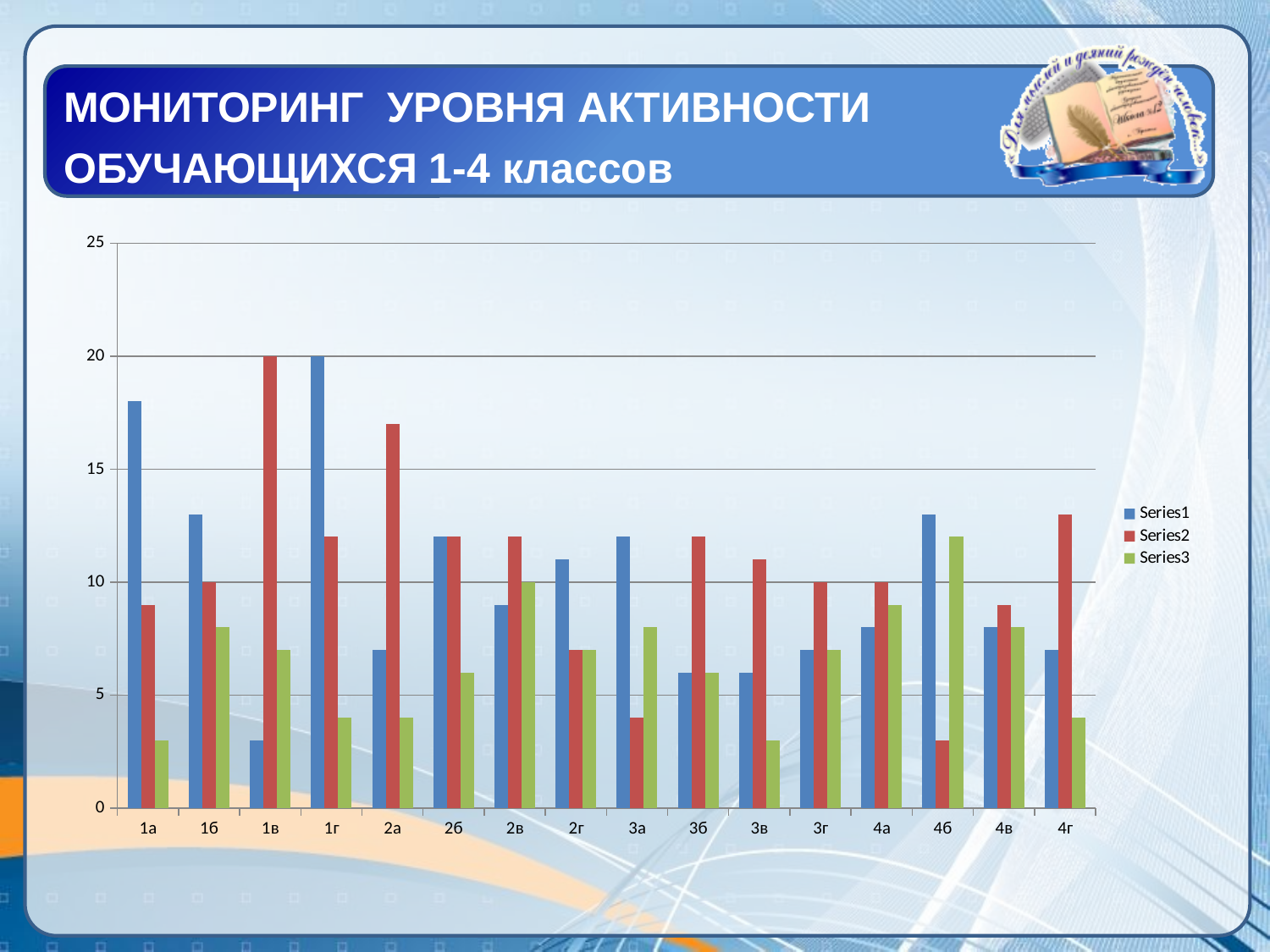
What kind of chart is shown on the slide? bar chart What is the value of Series1 for class 1г? 20 For which class is Series2 highest? 1в For class 1в, which is larger: Series1 or Series2? Series2 For which class is Series3 highest? 4б Is the value of Series1 for class 1а greater or less than 15? greater Is the value of Series3 for class 4б greater or less than 10? greater What is the value of Series2 for class 1в? 20 Is the value of Series2 for class 4б greater or less than 5? less What is the value of Series3 for class 2в? 10 How many series does the legend list? 3 How many class categories are shown on the x axis? 16